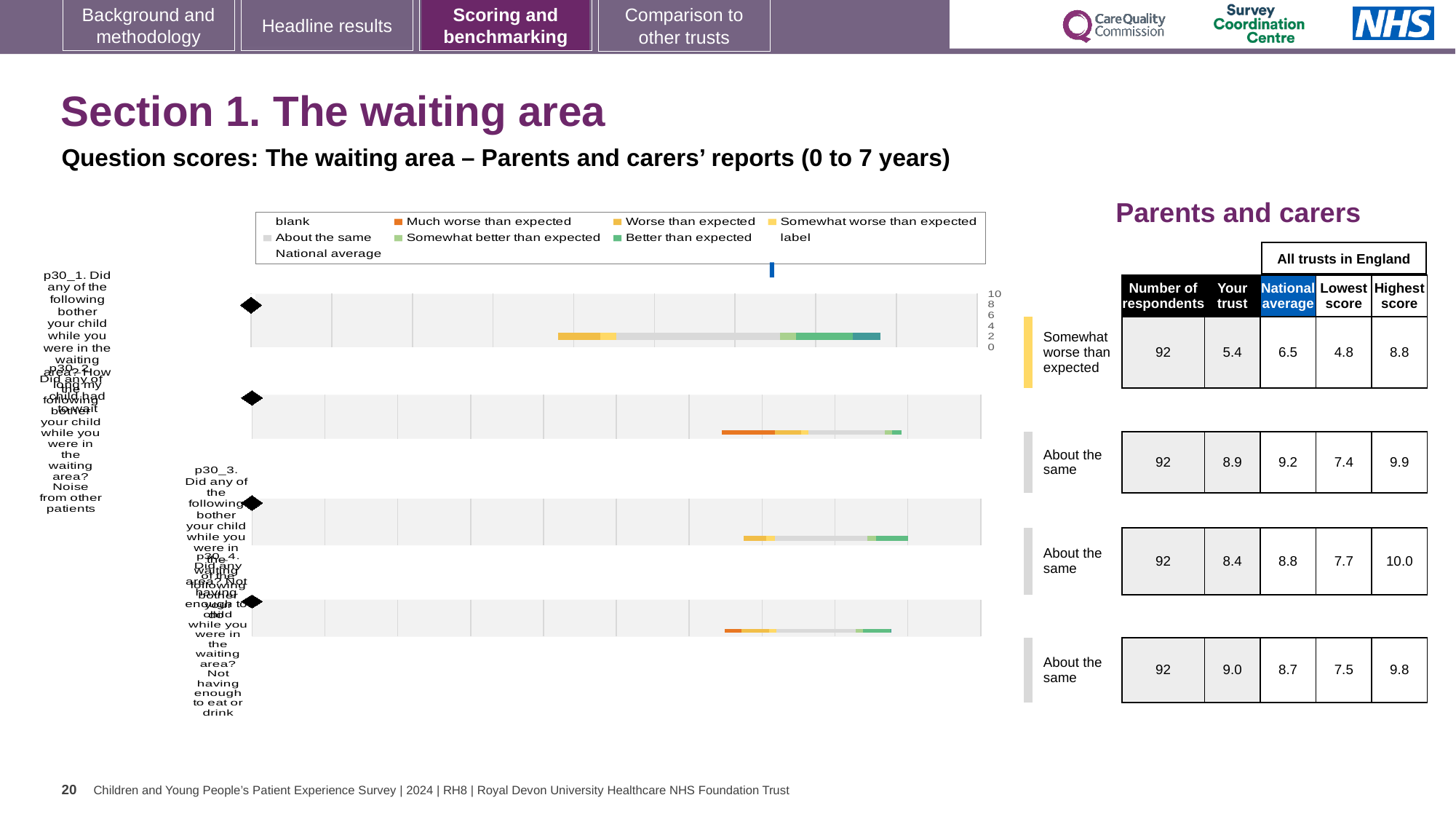
What is the national average score for the first row (p30_1)? 6.5 What kind of chart is used to show the question scores for the waiting area? Bar chart Which row has the highest 'Your trust' score? The fourth (bottom) row, p30_4, with 9.0 What is the 'Your trust' score for the first row (p30_1, noise from other patients)? 5.4 For the fourth row (p30_4), how much higher is the 'Your trust' score than the national average? 0.3 Which row has the lowest 'Your trust' score? The first row, p30_1, with 5.4 What benchmark category is assigned to the first row (p30_1)? Somewhat worse than expected How many respondents are listed for each question in the table? 92 For the first row (p30_1), what is the difference between the highest score and the lowest score across all trusts in England? 4.0 What is the subtitle describing the chart's question scores? Question scores: The waiting area – Parents and carers' reports (0 to 7 years) How many question rows (bars) are plotted in the waiting area chart? 4 For the second row (p30_2), which is larger: the 'Your trust' score or the national average? National average (9.2)